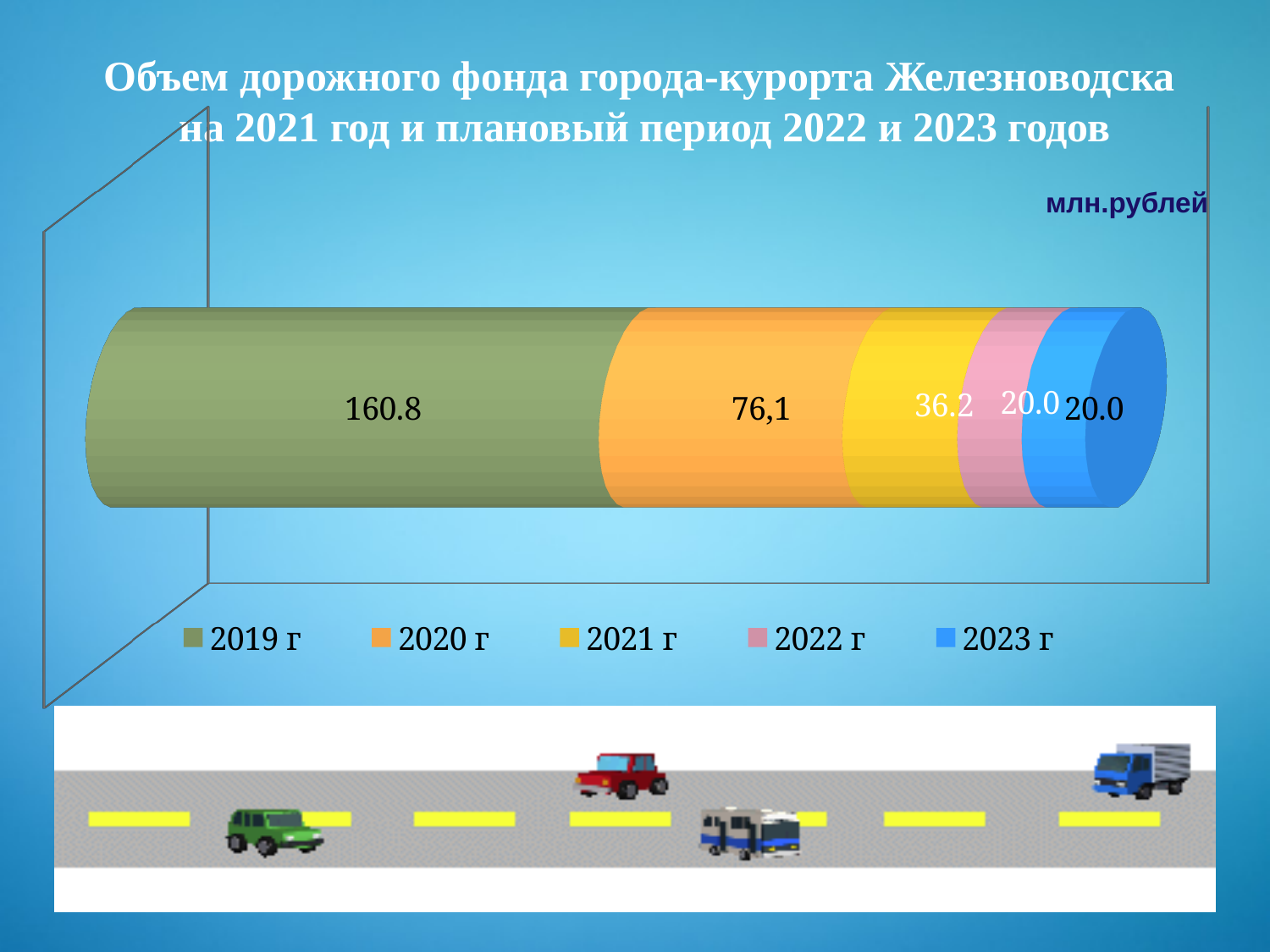
What is the value for 2022 г? 20.0 What is the value for 2020 г? 76,1 What is the value for 2021 г? 36.2 What is the difference between the values for 2021 г and 2022 г? 16.2 How many series does the legend list? 5 What is the difference between the values for 2019 г and 2020 г? 84.7 What unit of measurement is indicated for the chart values? млн.рублей What is the total of all segments in the stacked bar? 313.1 Which is larger, the value for 2020 г or the value for 2021 г? 2020 г Which year has the highest value? 2019 г What kind of chart is shown on the slide? Stacked bar chart What is the value for 2019 г? 160.8